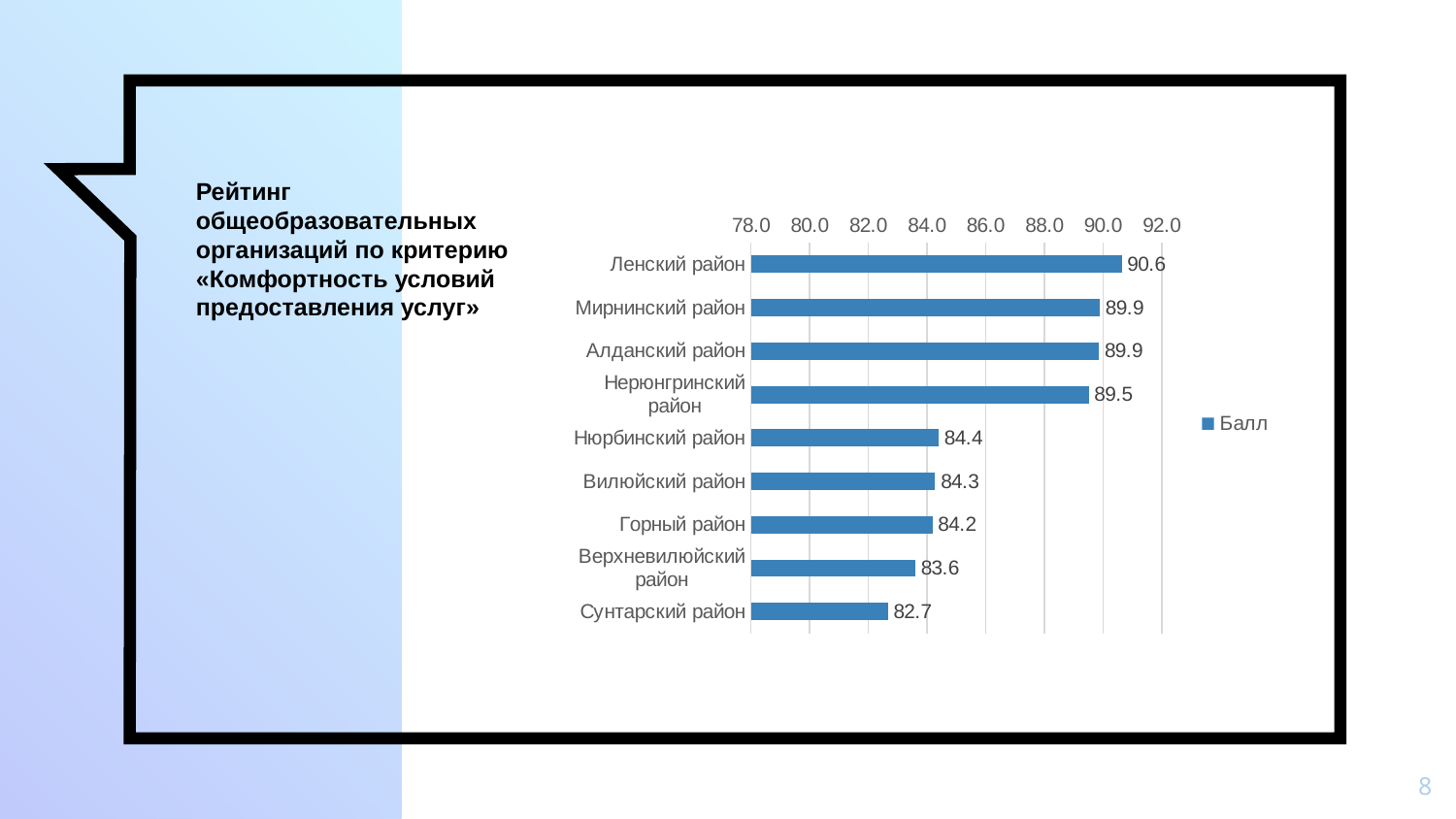
Which is larger, the value for Нюрбинский район or the value for Верхневилюйский район? Нюрбинский район What is the value for Ленский район? 90.6 What series name does the legend show? Балл Is the value for Горный район greater or less than 86.0? less What is the difference between the values for Ленский район and Сунтарский район? 7.9 How many districts are shown in the chart? 9 Which district has the lowest value? Сунтарский район What is the value for Верхневилюйский район? 83.6 Which district has the highest value? Ленский район What kind of chart is shown on the slide? bar chart What is the value for Нерюнгринский район? 89.5 What is the value for Сунтарский район? 82.7